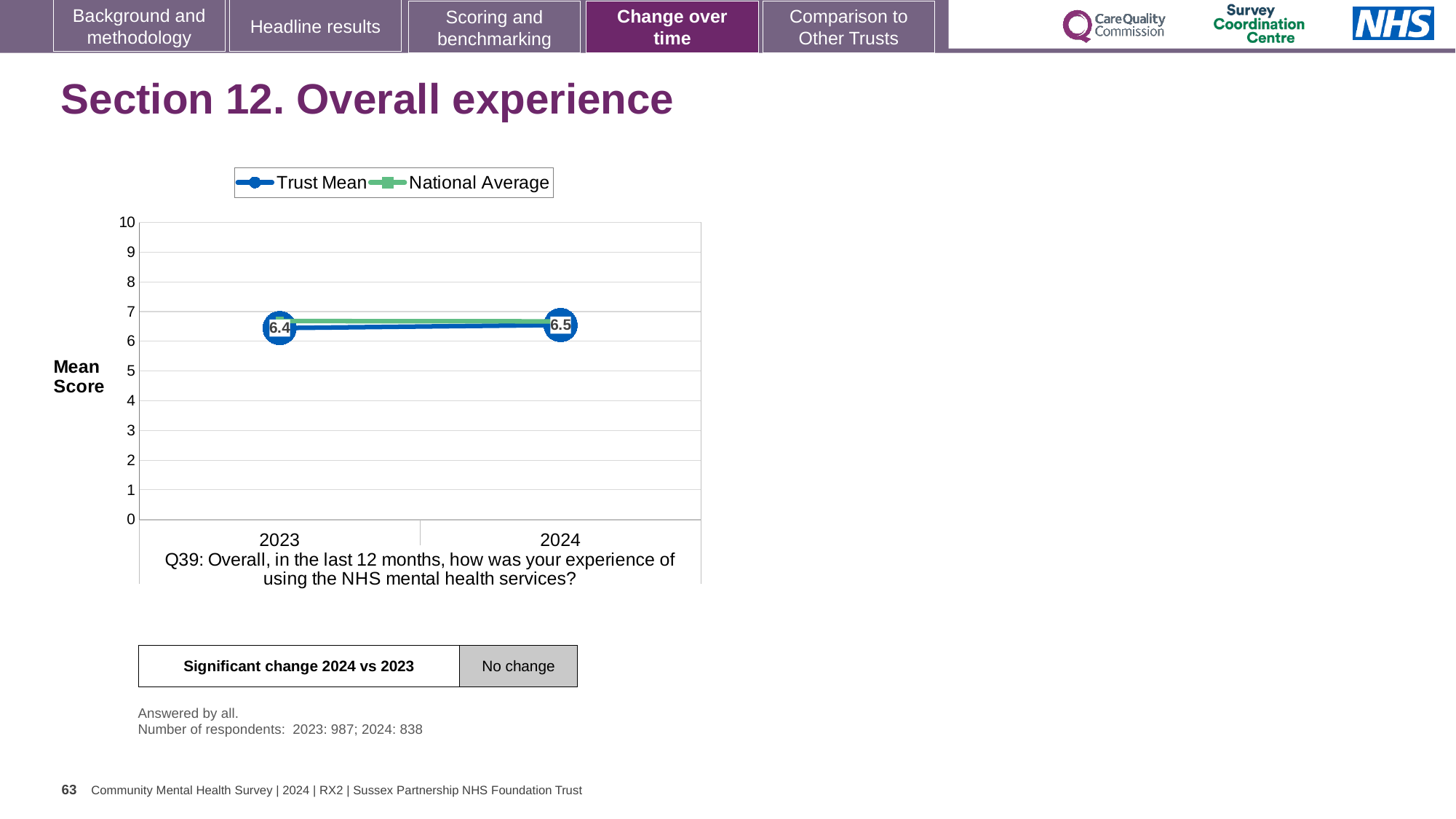
Which year has the higher Trust Mean value, 2023 or 2024? 2024 What kind of chart is shown on the slide? line chart How many years are plotted on the x axis? 2 What is the Trust Mean value for 2024? 6.5 What are the two series named in the legend? Trust Mean and National Average Does the Trust Mean rise or fall from 2023 to 2024? rise What is the Trust Mean value for 2023? 6.4 Is the National Average value for 2023 greater or less than 5? greater What is the difference between the Trust Mean values for 2024 and 2023? 0.1 Which year has the lowest Trust Mean value? 2023 How many series does the legend list? 2 What is the label on the y axis of the chart? Mean Score